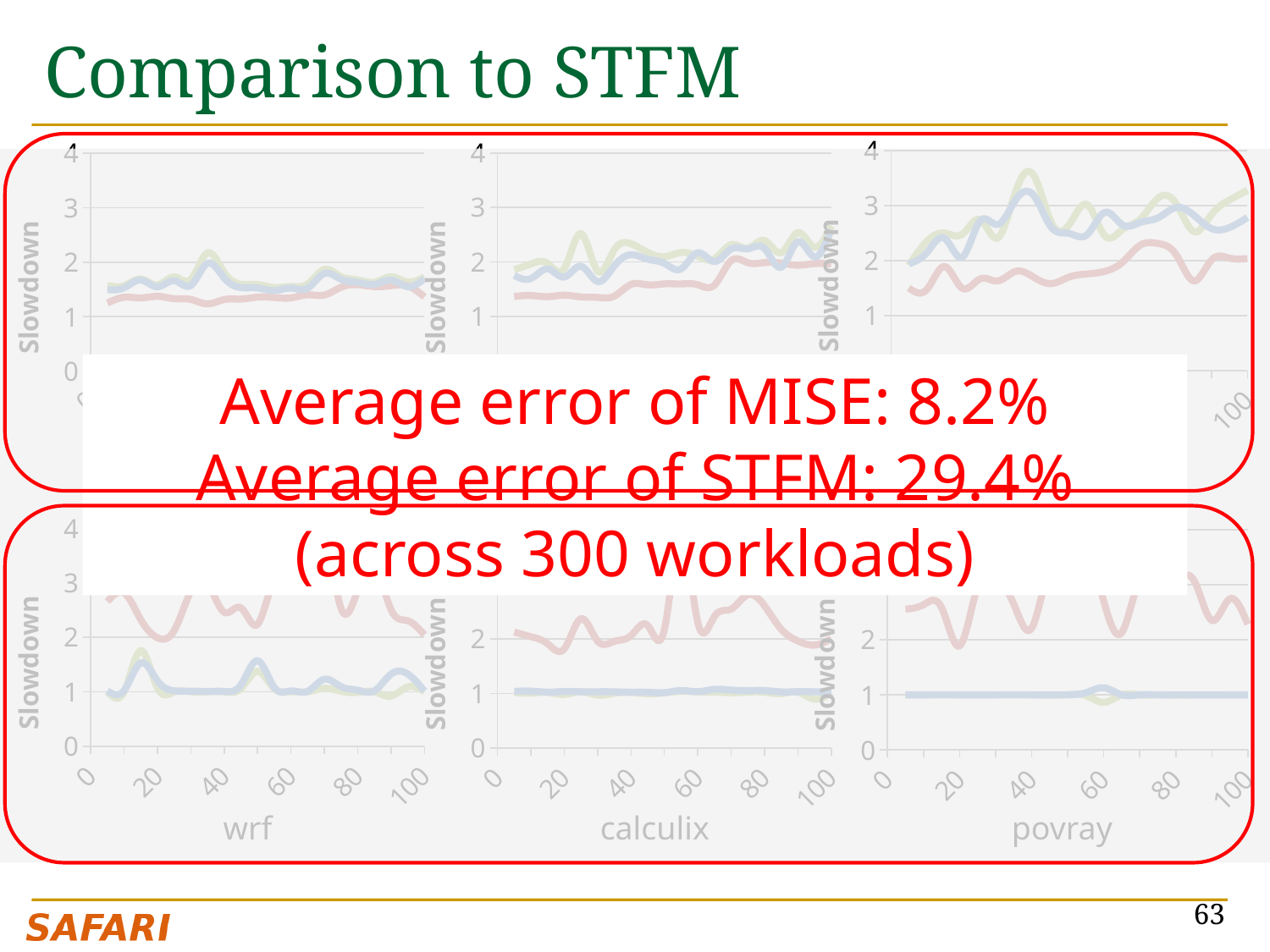
In the bottom wrf chart at x=40, which line is higher, the red line or the blue line? red What is the x-axis label of the bottom-middle chart? calculix How many charts are shown on the slide? 6 In the bottom povray chart, is the value of the blue line at x=40 greater or less than 2? less In the top-right chart, does the blue line generally rise or fall between x=0 and x=40? rise In the top-right chart at x=40, which line is higher, the blue line or the red line? blue In the bottom wrf chart, is the value of the red line at x=20 greater or less than 1? greater In the top-right chart, is the value of the red line at x=20 greater or less than 3? less What is the y-axis label on the charts? Slowdown What kind of chart is the bottom-left chart labelled "wrf"? line chart